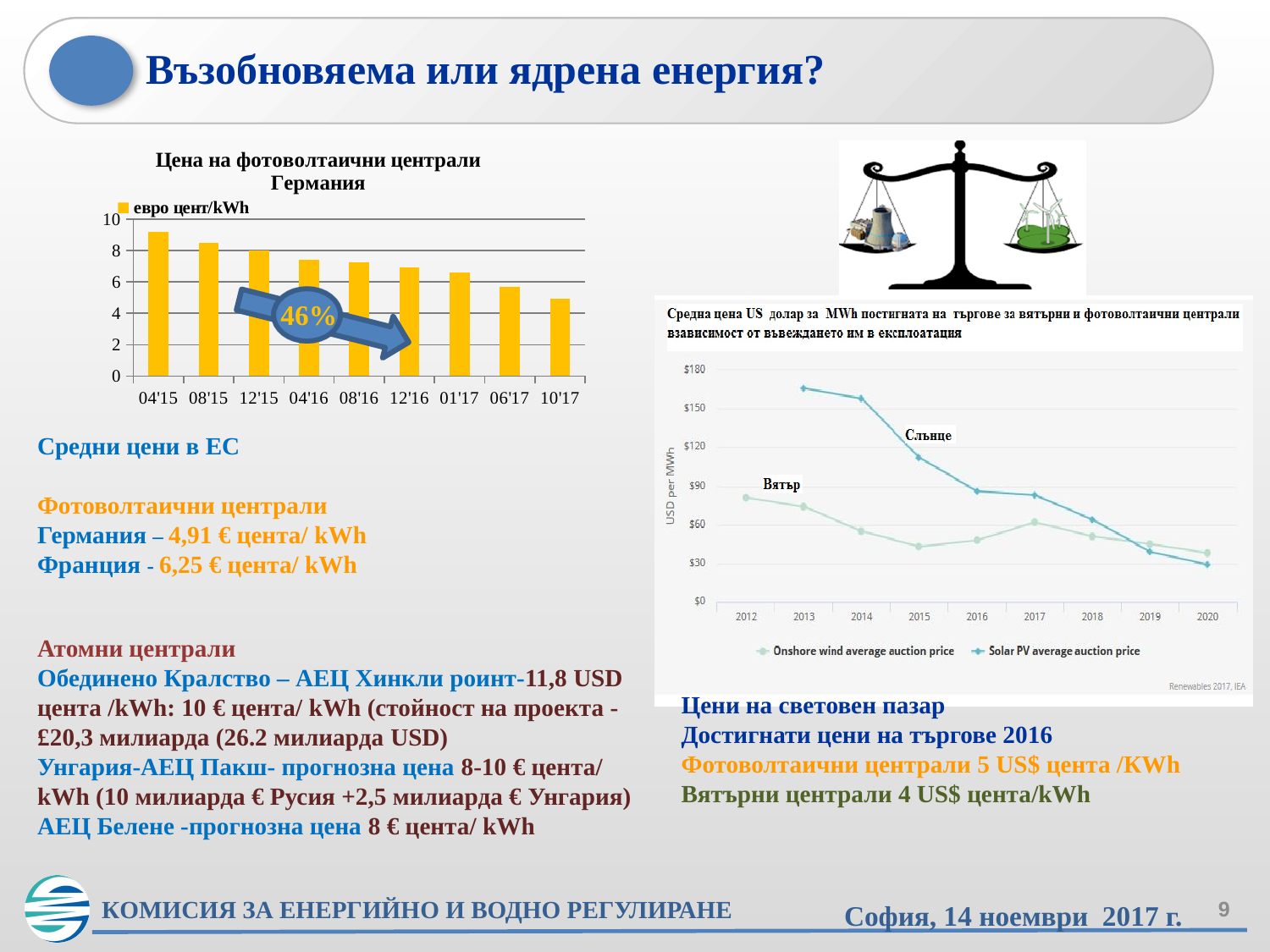
In the line chart on the right of the slide, is the Solar PV average auction price for 2013 greater or less than $150? greater In the chart titled "Цена на фотоволтаични централи Германия", which is larger, the value for 08'15 or the value for 06'17? 08'15 How many bars are plotted in the chart titled "Цена на фотоволтаични централи Германия"? 9 In the chart titled "Цена на фотоволтаични централи Германия", which category has the lowest value? 10'17 In the chart titled "Цена на фотоволтаични централи Германия", is the value for 04'15 greater or less than 8? greater In the chart titled "Цена на фотоволтаични централи Германия", is the value for 10'17 greater or less than 6? less What kind of chart is the chart titled "Цена на фотоволтаични централи Германия"? bar chart In the chart titled "Цена на фотоволтаични централи Германия", which category has the highest value? 04'15 In the chart titled "Цена на фотоволтаични централи Германия", do the values rise or fall from 04'15 to 10'17? fall In the line chart on the right of the slide, which series has the higher value in 2014, Onshore wind average auction price or Solar PV average auction price? Solar PV average auction price How many series does the legend of the line chart on the right of the slide list? 2 What is the legend entry of the chart titled "Цена на фотоволтаични централи Германия"? евро цент/kWh